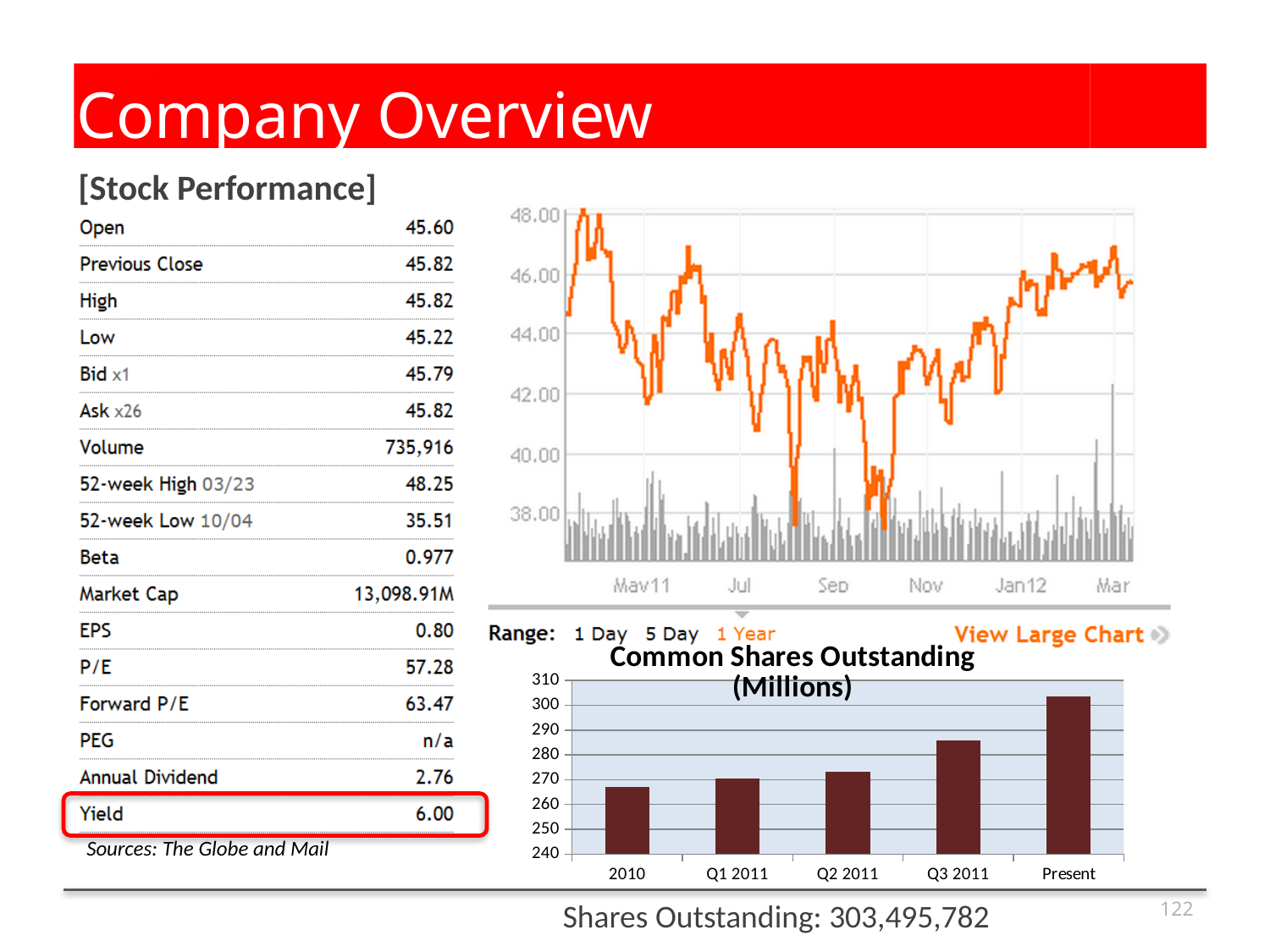
What kind of chart is the stock price chart at the top right of the slide? line chart What is the highest value shown on the y axis of the stock price line chart? 48.00 How many categories are shown on the x axis of the Common Shares Outstanding bar chart? 5 What kind of chart is the Common Shares Outstanding chart at the bottom right of the slide? bar chart In the Common Shares Outstanding bar chart, which is larger, the value for Q3 2011 or the value for Q1 2011? Q3 2011 In the Common Shares Outstanding bar chart, is the value for Present greater or less than 290? greater In the Common Shares Outstanding bar chart, which category has the highest value? Present In the Common Shares Outstanding bar chart, is the value for Q2 2011 greater or less than 280? less In the Common Shares Outstanding bar chart, which category has the lowest value? 2010 In the Common Shares Outstanding bar chart, is the value for Q3 2011 greater or less than 280? greater In the Common Shares Outstanding bar chart, do the values rise or fall from 2010 to Present? rise What is the title of the bar chart at the bottom right of the slide? Common Shares Outstanding (Millions)